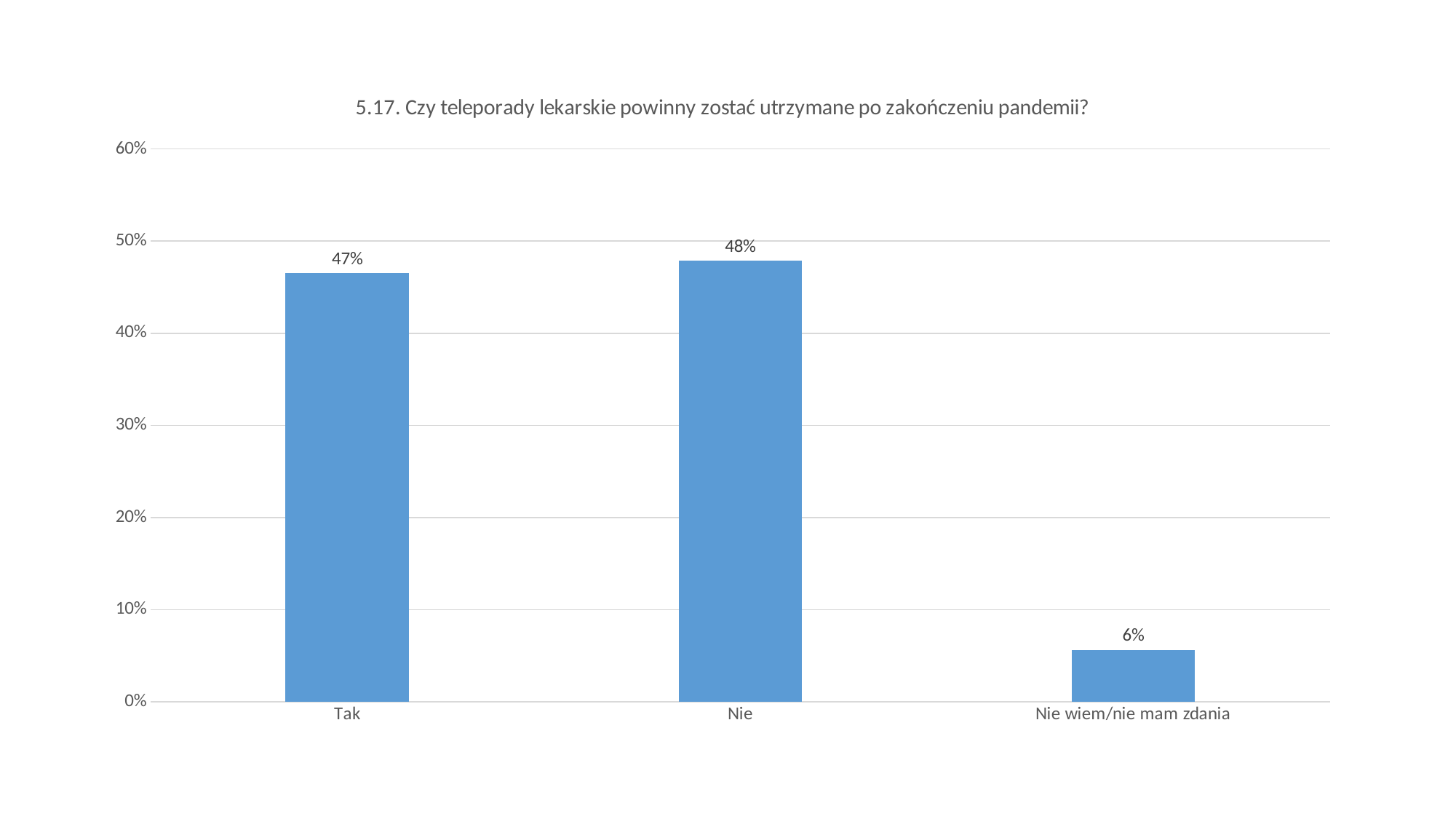
How many categories are shown on the x axis? 3 Is the value for "Tak" greater or less than 40%? greater What is the difference between the values for "Nie" and "Tak"? 1 percentage point What is the value for "Nie wiem/nie mam zdania"? 6% Which category has the lowest value? Nie wiem/nie mam zdania What is the value for "Nie"? 48% According to the data labels, which is larger: the value for "Tak" or the value for "Nie"? Nie Which category has the highest value according to the data labels? Nie What is the value for "Tak"? 47% What kind of chart is shown on the slide? bar chart Is the value for "Nie wiem/nie mam zdania" greater or less than 10%? less What is the difference between the values for "Tak" and "Nie wiem/nie mam zdania"? 41 percentage points